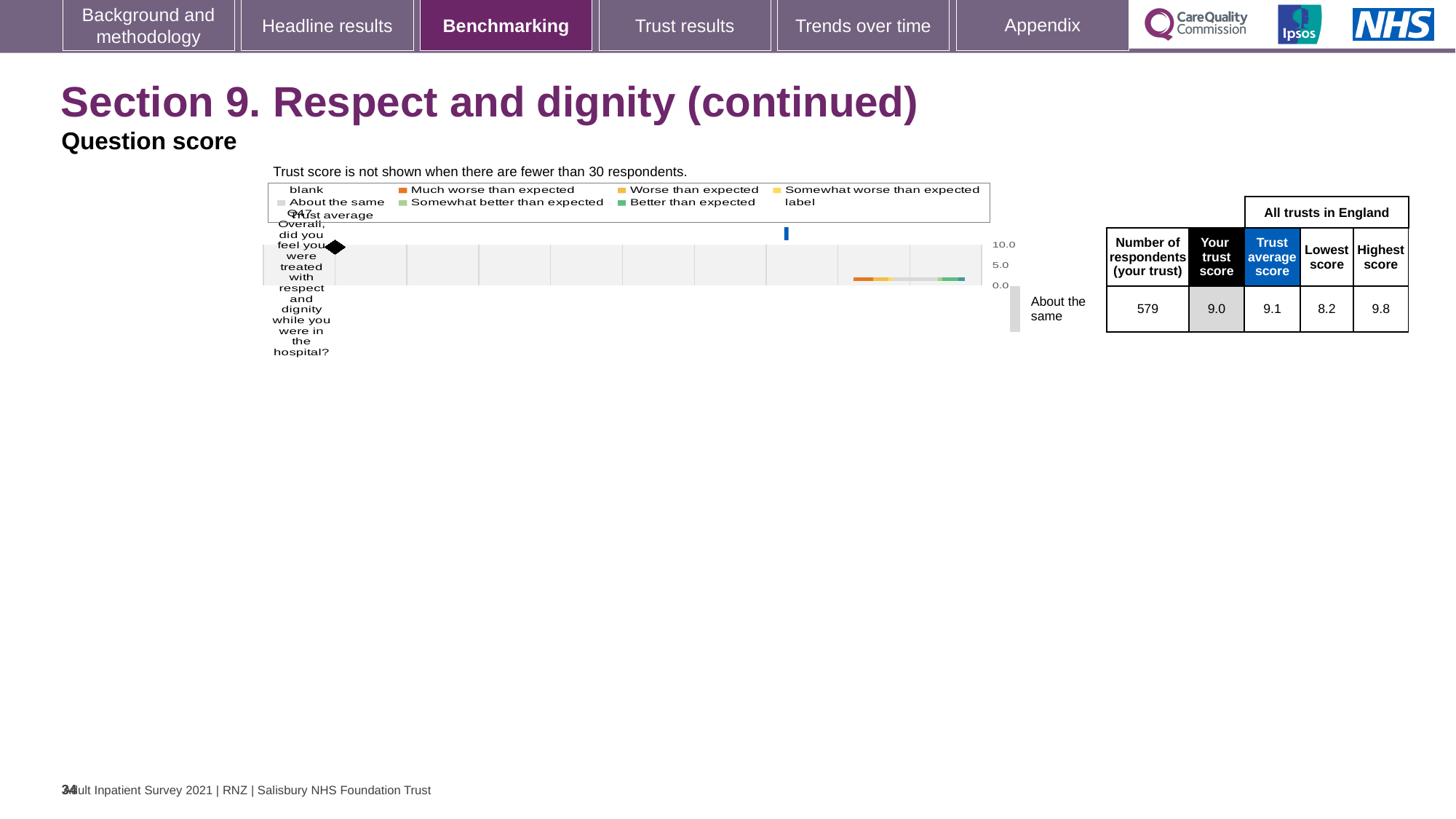
Which question number is plotted on the chart? Q47 What is the lowest score among all trusts in England for Q47? 8.2 What is the highest value shown on the chart's axis? 10.0 What is the difference between the highest score and the lowest score for Q47 across all trusts in England? 1.6 Is the trust's score for Q47 greater or less than 5.0? greater What is the highest score among all trusts in England for Q47? 9.8 What is the trust's score for Q47 according to the table next to the chart? 9.0 What kind of chart is shown on the slide? bar chart What is the trust average score for Q47 across all trusts in England? 9.1 How many respondents from the trust answered Q47? 579 How many survey questions are plotted on the chart? 1 Which is larger for Q47: the trust's score or the trust average score? Trust average score